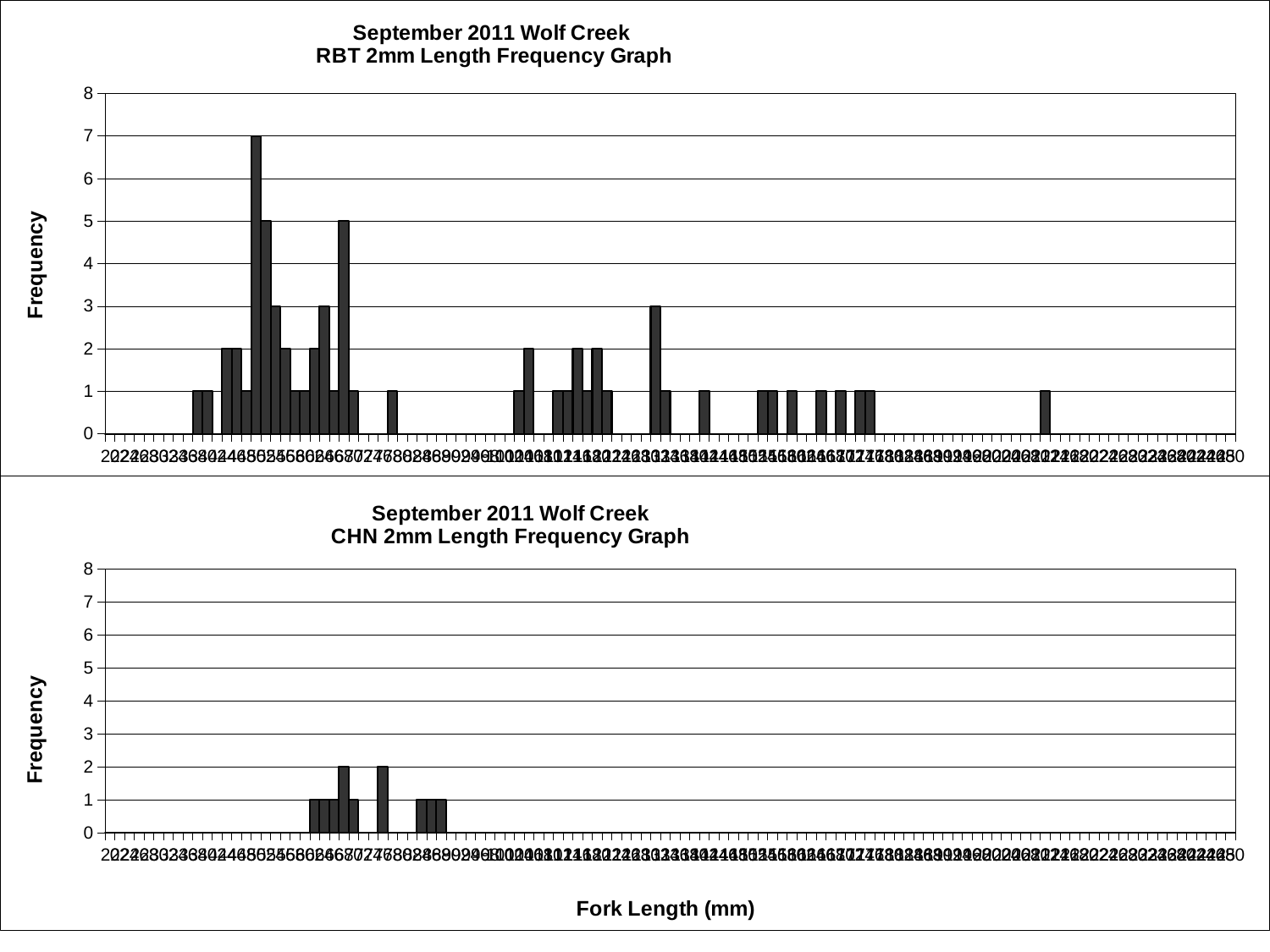
What kind of chart is the bottom chart, 'September 2011 Wolf Creek CHN 2mm Length Frequency Graph'? bar chart In the top chart (RBT 2mm Length Frequency Graph), what is the highest frequency reached by any bar? 7 In the top RBT chart, how many bars reach a frequency of 7? 1 In the bottom CHN chart, how many bars reach a frequency of 2? 2 What is the title of the top chart? September 2011 Wolf Creek RBT 2mm Length Frequency Graph Which chart has the taller maximum bar, the RBT chart on top or the CHN chart on the bottom? RBT chart What kind of chart is the top chart, 'September 2011 Wolf Creek RBT 2mm Length Frequency Graph'? bar chart In the bottom CHN chart, is the tallest bar greater or less than 4? less In the bottom chart (CHN 2mm Length Frequency Graph), what is the highest frequency reached by any bar? 2 What is the difference between the tallest bar in the top RBT chart and the tallest bar in the bottom CHN chart? 5 What is the x-axis label shown at the bottom of the slide? Fork Length (mm) In the top RBT chart, is the tallest bar greater or less than 5? greater